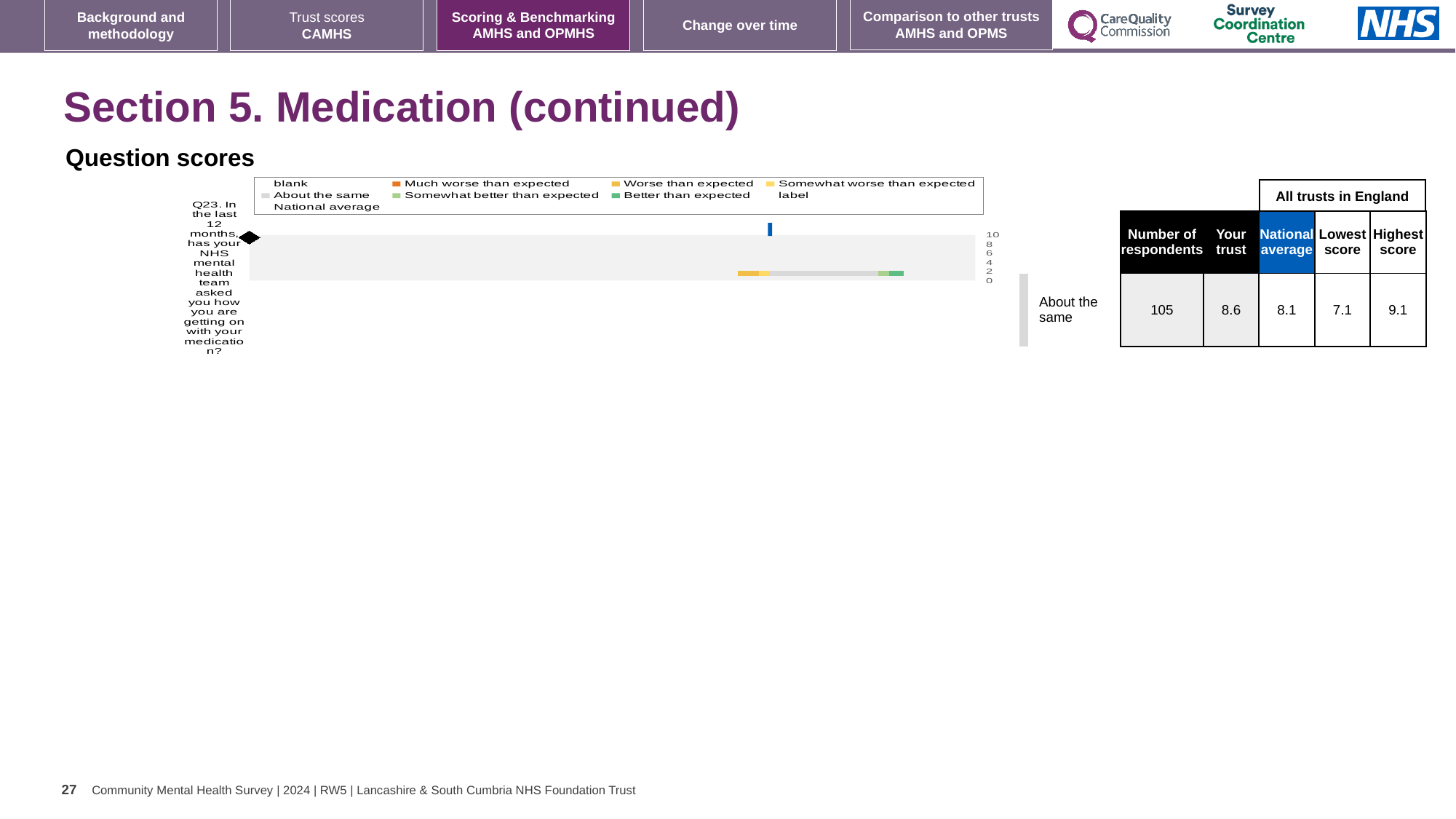
In the table beside the Question scores chart, what is the National average for Q23? 8.1 In the Question scores chart legend, what colour represents 'Better than expected'? green In the table beside the Question scores chart, how many respondents answered Q23? 105 How many survey questions are plotted in the Question scores chart? 1 In the Question scores chart legend, what colour represents 'Much worse than expected'? orange For Q23, what is the difference between the 'Your trust' score and the National average? 0.5 What kind of chart is shown under 'Question scores'? bar chart In the table beside the Question scores chart, what is the Highest score for Q23? 9.1 In the table beside the Question scores chart, what is the 'Your trust' score for Q23? 8.6 Which benchmark category is shown for Q23 next to the Question scores chart? About the same In the table beside the Question scores chart, what is the Lowest score for Q23? 7.1 For Q23, which is larger: the 'Your trust' score or the National average? Your trust